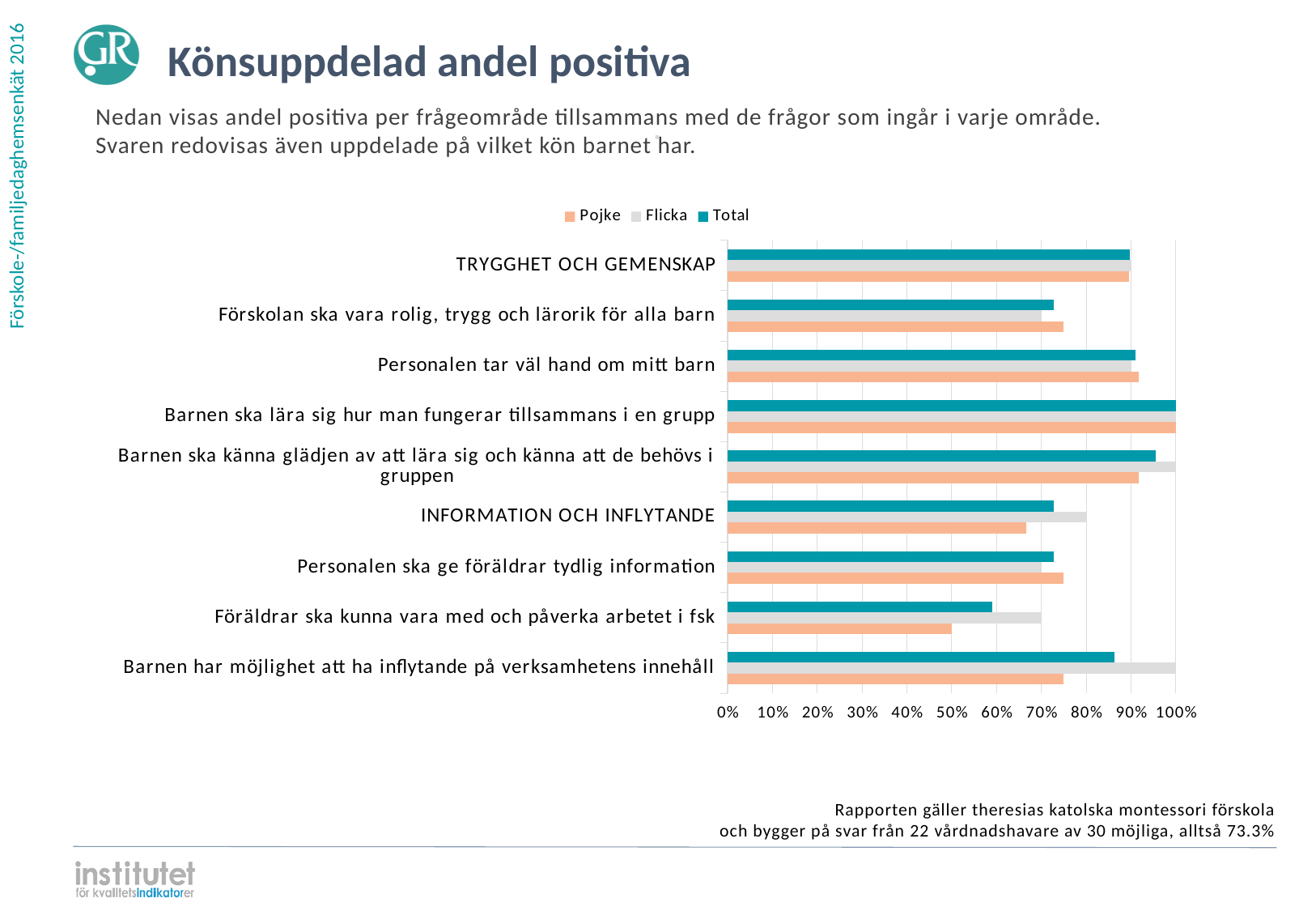
What is the Total value for 'Barnen ska lära sig hur man fungerar tillsammans i en grupp'? 100% Is the Pojke value for 'INFORMATION OCH INFLYTANDE' greater or less than 70%? less What is the Pojke value for 'Föräldrar ska kunna vara med och påverka arbetet i fsk'? 50% Which series is shown in orange in the legend? Pojke What kind of chart is shown on the slide? bar chart Which category has the lowest Pojke value? Föräldrar ska kunna vara med och påverka arbetet i fsk How many series does the legend list? 3 Is the Total value for 'Barnen har möjlighet att ha inflytande på verksamhetens innehåll' greater or less than 80%? greater How many categories are plotted on the chart? 9 What is the Flicka value for 'Barnen har möjlighet att ha inflytande på verksamhetens innehåll'? 100% For 'Barnen har möjlighet att ha inflytande på verksamhetens innehåll', which is larger, the Pojke value or the Flicka value? Flicka What is the Flicka value for 'INFORMATION OCH INFLYTANDE'? 80%